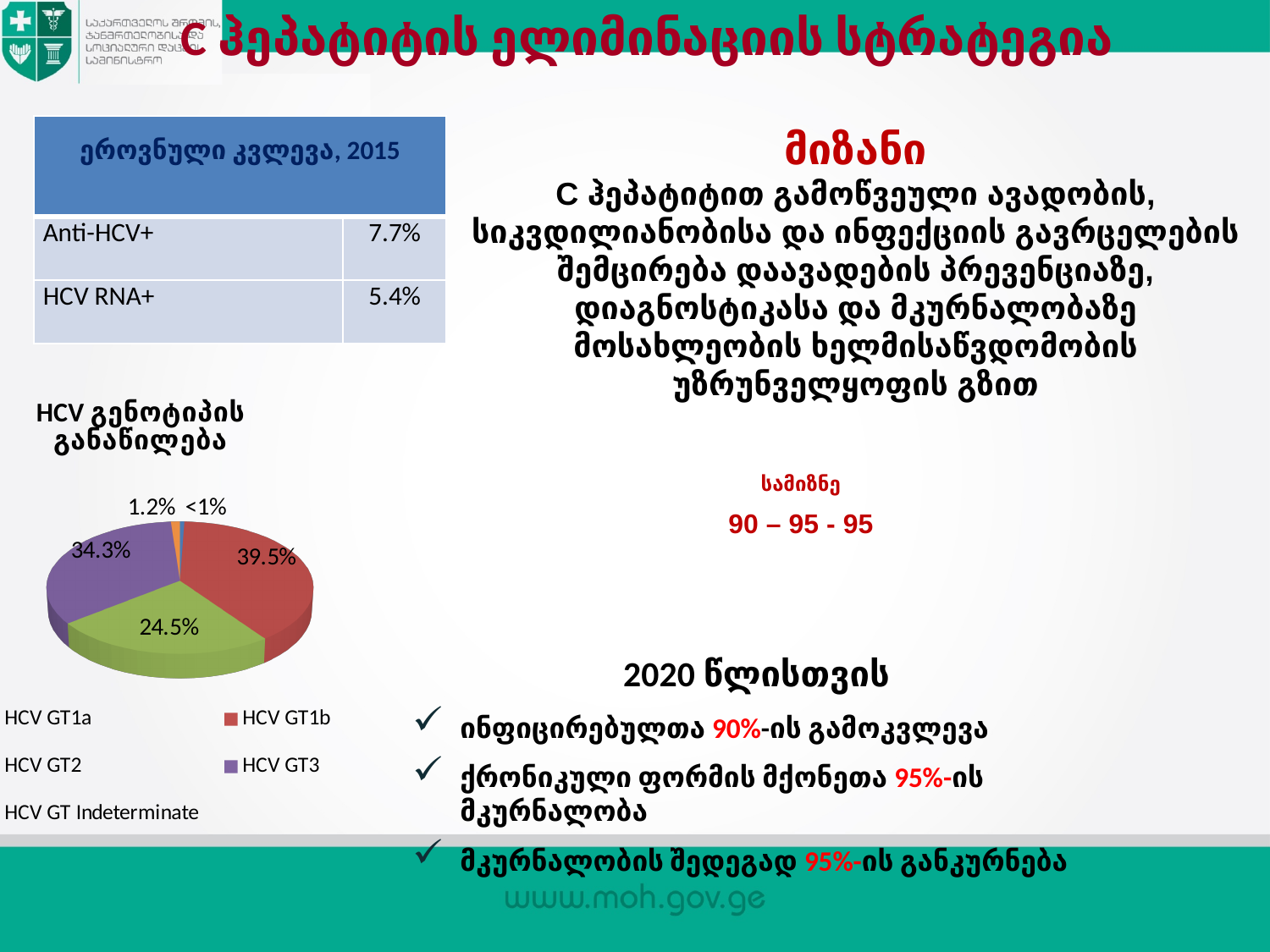
In the HCV genotype distribution pie chart, which is larger: HCV GT2 or HCV GT3? HCV GT3 In the HCV genotype distribution pie chart, what percentage is shown for HCV GT1b? 39.5% What type of chart is used to show the HCV genotype distribution? pie chart In the HCV genotype distribution pie chart, what percentage is shown for HCV GT2? 24.5% In the HCV genotype distribution pie chart, what percentage is shown for HCV GT3? 34.3% What colour is the HCV GT3 slice in the HCV genotype distribution pie chart? purple How many categories does the legend of the HCV genotype distribution pie chart list? 5 In the HCV genotype distribution pie chart, what is the difference between the HCV GT1b and HCV GT3 shares? 5.2% What colour is the HCV GT1b slice in the HCV genotype distribution pie chart? red What is the smallest percentage label shown on the HCV genotype distribution pie chart? <1% Which genotype has the largest slice in the HCV genotype distribution pie chart? HCV GT1b In the HCV genotype distribution pie chart, what is the difference between the HCV GT3 and HCV GT2 shares? 9.8%